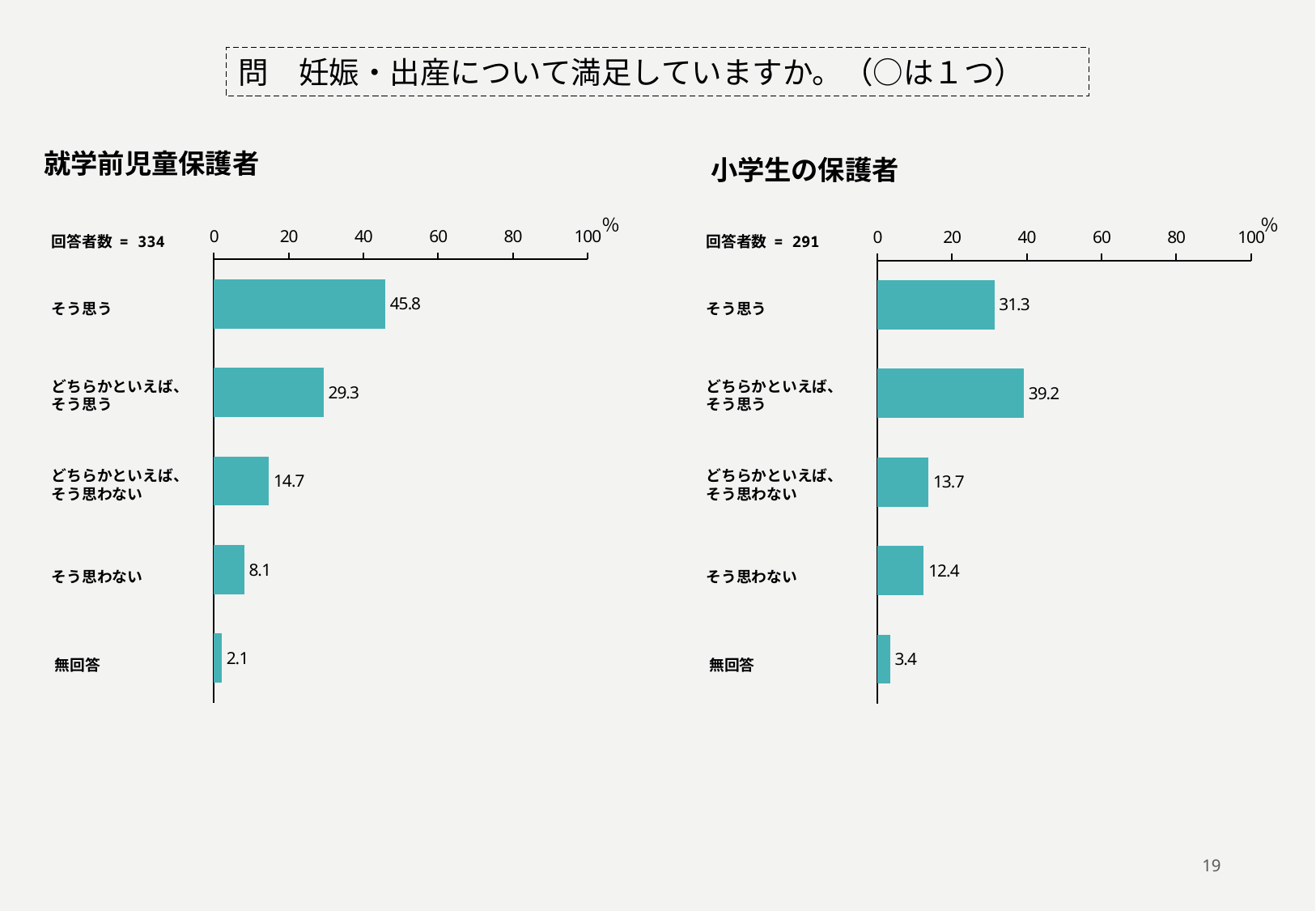
In the 就学前児童保護者 chart on the left, which category has the highest value? そう思う In the 就学前児童保護者 chart on the left, what is the value for そう思う? 45.8 In the 小学生の保護者 chart on the right, which is larger: そう思う or どちらかといえば、そう思う? どちらかといえば、そう思う In the 小学生の保護者 chart on the right, what is the value for そう思わない? 12.4 What kind of chart is the 就学前児童保護者 chart on the left? bar chart In the 就学前児童保護者 chart on the left, what is the difference between そう思う and どちらかといえば、そう思う? 16.5 How many categories are shown in the 小学生の保護者 chart on the right? 5 In the 小学生の保護者 chart on the right, which category has the lowest value? 無回答 In the 小学生の保護者 chart on the right, what is the difference between どちらかといえば、そう思わない and そう思わない? 1.3 In the 小学生の保護者 chart on the right, what is the value for どちらかといえば、そう思う? 39.2 In the 就学前児童保護者 chart on the left, is the value for そう思う greater or less than 40? greater In the 就学前児童保護者 chart on the left, what is the number of respondents (回答者数)? 334